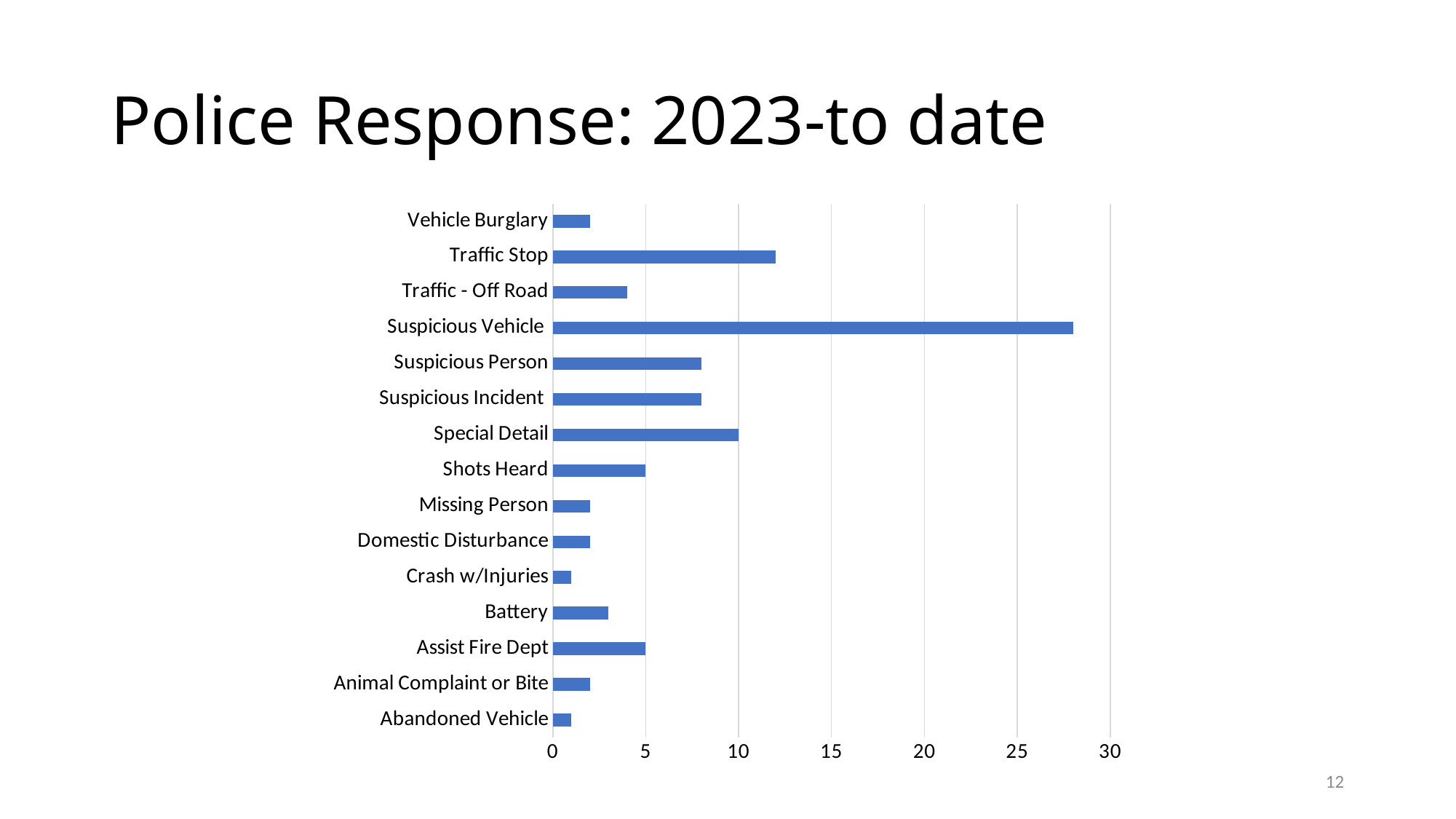
Which is larger, the value for Suspicious Vehicle or the value for Traffic Stop? Suspicious Vehicle Is the value for Traffic - Off Road greater or less than 5? less Is the value for Traffic Stop greater or less than 10? greater Is the value for Suspicious Vehicle greater or less than 25? greater What is the value for Assist Fire Dept? 5 Which is larger, the value for Traffic Stop or the value for Special Detail? Traffic Stop What is the value for Shots Heard? 5 Which category has the highest value? Suspicious Vehicle What kind of chart is shown on the slide? Bar chart How many categories are plotted in the chart? 15 What is the title of the slide? Police Response: 2023-to date What is the value for Special Detail? 10